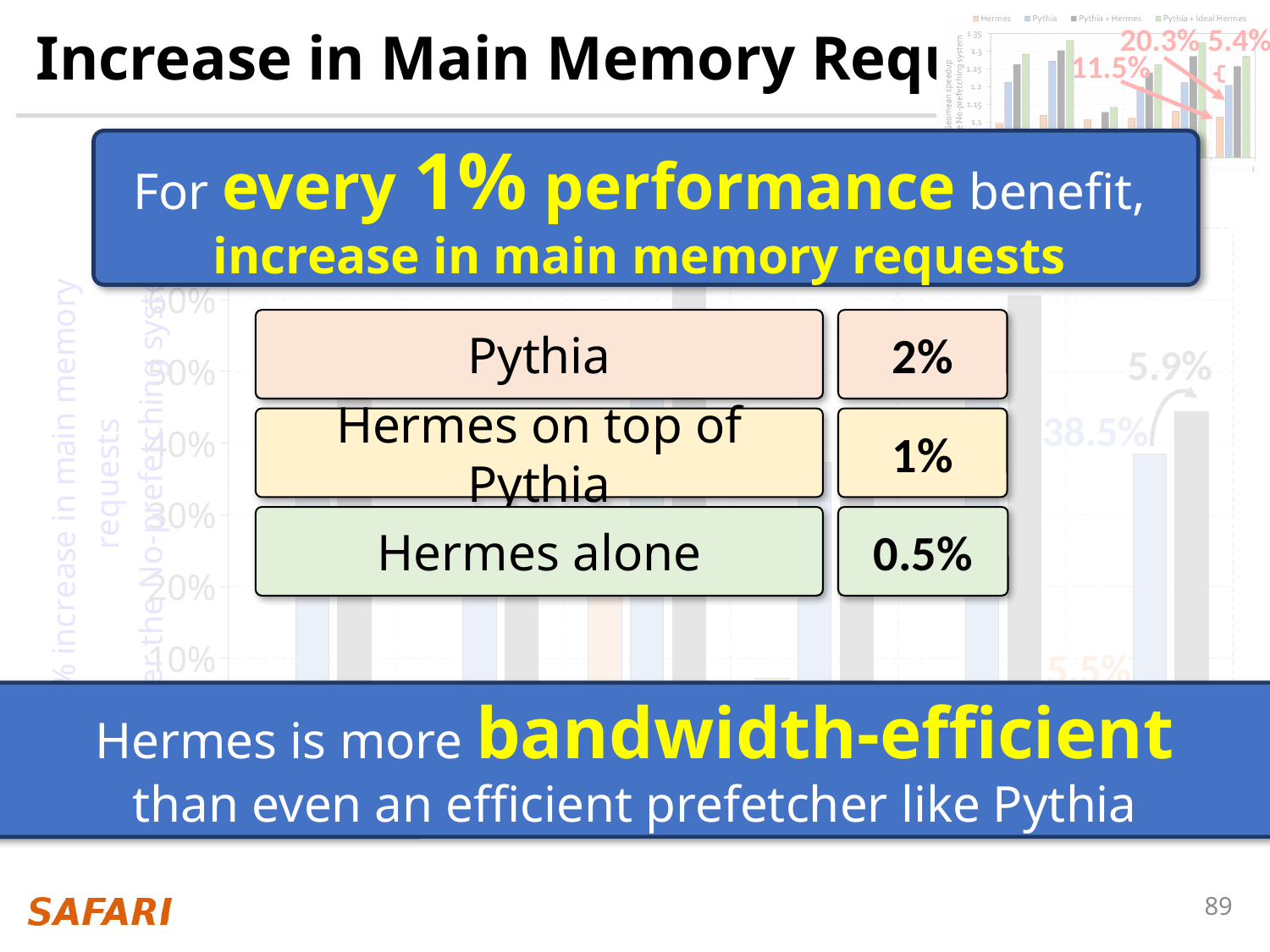
What kind of chart is the small inset chart in the top-right corner of the slide? bar chart On the large background chart, what is the highest y-axis tick label shown? 60% On the large background chart, what value is printed as the data label on the tall light-blue bar at the right side? 38.5% On the small inset chart in the top-right corner, what is the lowest y-axis tick label shown? 1.1 What are the series names in the legend of the small inset chart in the top-right corner? Hermes, Pythia, Pythia + Hermes, Pythia + Ideal Hermes On the large background chart, what percentage is printed next to the arrow above the rightmost bars? 5.9% What kind of chart is the large chart in the background of the slide? bar chart How many series does the legend of the small inset chart in the top-right corner list? 4